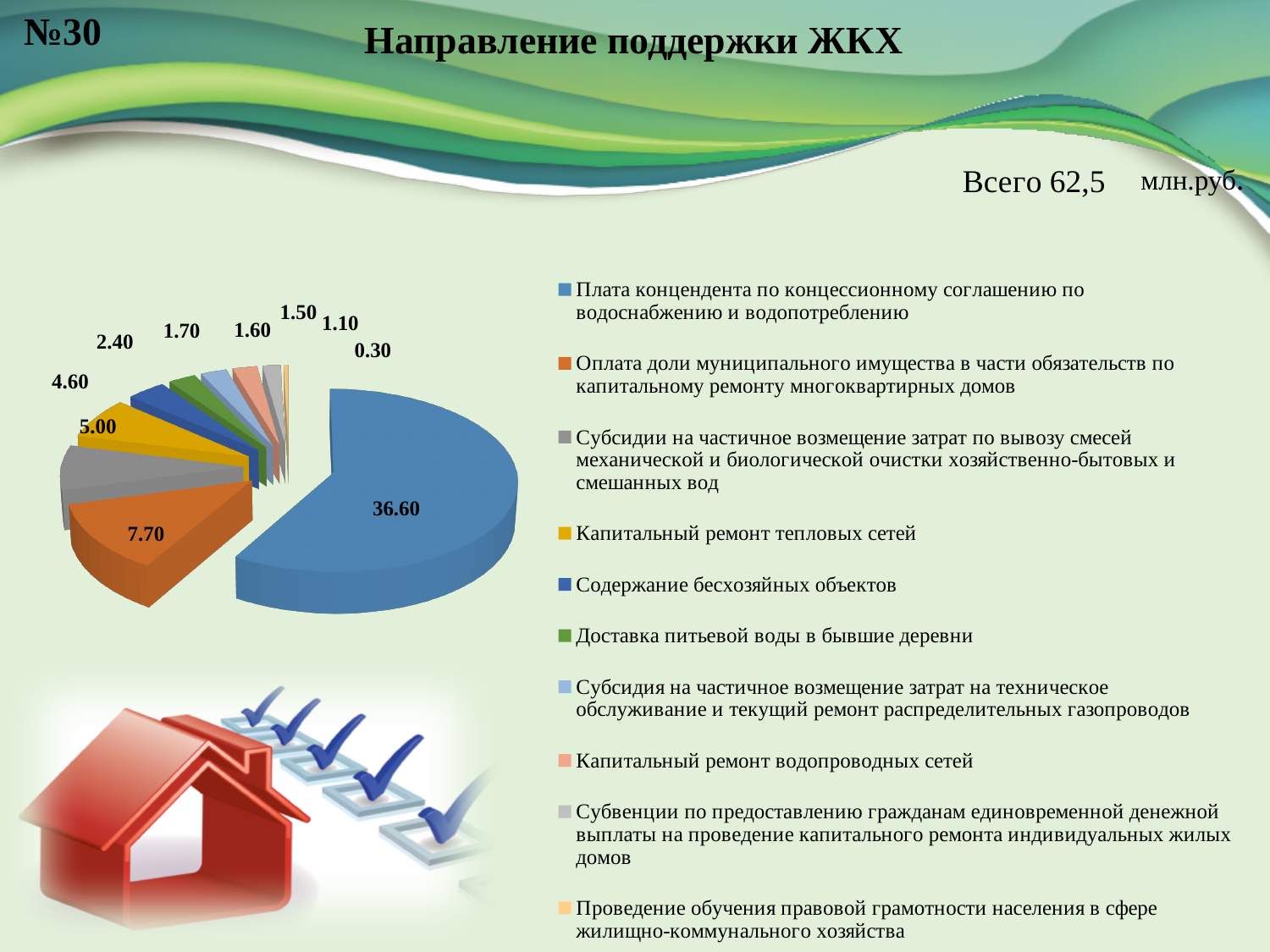
What kind of chart is shown on the slide? pie chart What is the value for Оплата доли муниципального имущества в части обязательств по капитальному ремонту многоквартирных домов? 7.70 What is the difference between the largest slice (36.60) and the second largest slice (7.70)? 28.90 Which category has the smallest slice in the pie chart? Проведение обучения правовой грамотности населения в сфере жилищно-коммунального хозяйства What is the value of the largest slice of the pie chart? 36.60 What total amount in million rubles is stated on the slide? 62,5 What is the value for Капитальный ремонт тепловых сетей? 4.60 What is the title of the slide? Направление поддержки ЖКХ Which category has the largest slice in the pie chart? Плата концендента по концессионному соглашению по водоснабжению и водопотреблению How many entries does the legend of the pie chart list? 10 What is the value for Содержание бесхозяйных объектов? 2.40 Which is larger: the slice for Доставка питьевой воды в бывшие деревни or the slice for Капитальный ремонт водопроводных сетей? Доставка питьевой воды в бывшие деревни